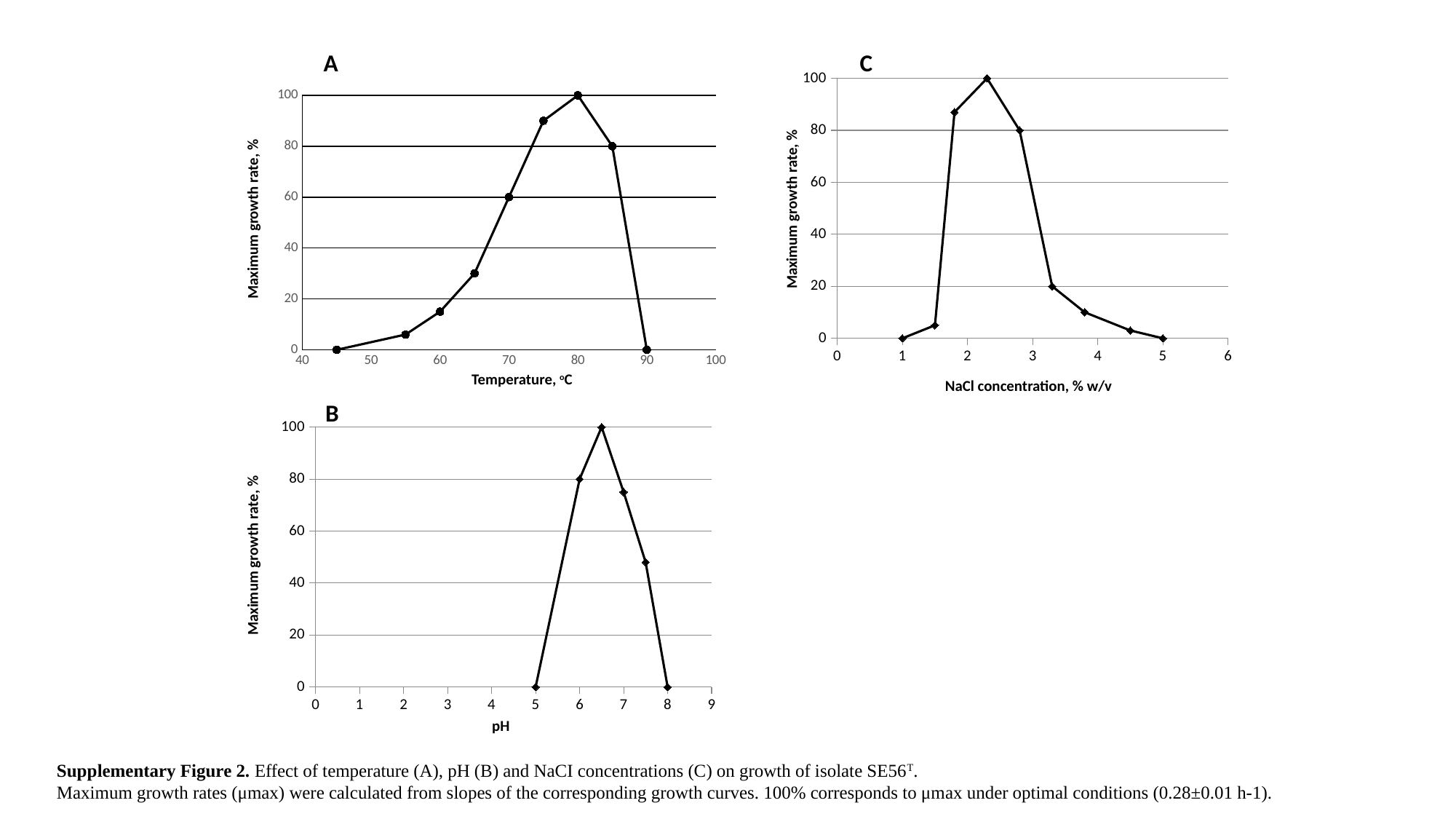
What kind of chart is chart C? line chart In chart B, is the value at pH 7 greater or less than 60? greater In chart C, is the value at 3.8% NaCl greater or less than 20? less In chart A, what is the maximum growth rate at 80 °C? 100 In chart A, what is the maximum growth rate at 70 °C? 60 How many data points are plotted in chart B? 6 In chart B, what is the maximum growth rate at pH 6? 80 In chart A, what is the maximum growth rate at 90 °C? 0 In chart A, is the value at 75 °C greater or less than 80? greater In chart A, at which temperature is the maximum growth rate highest? 80 °C In chart A, does the growth rate rise or fall between 45 °C and 80 °C? rise